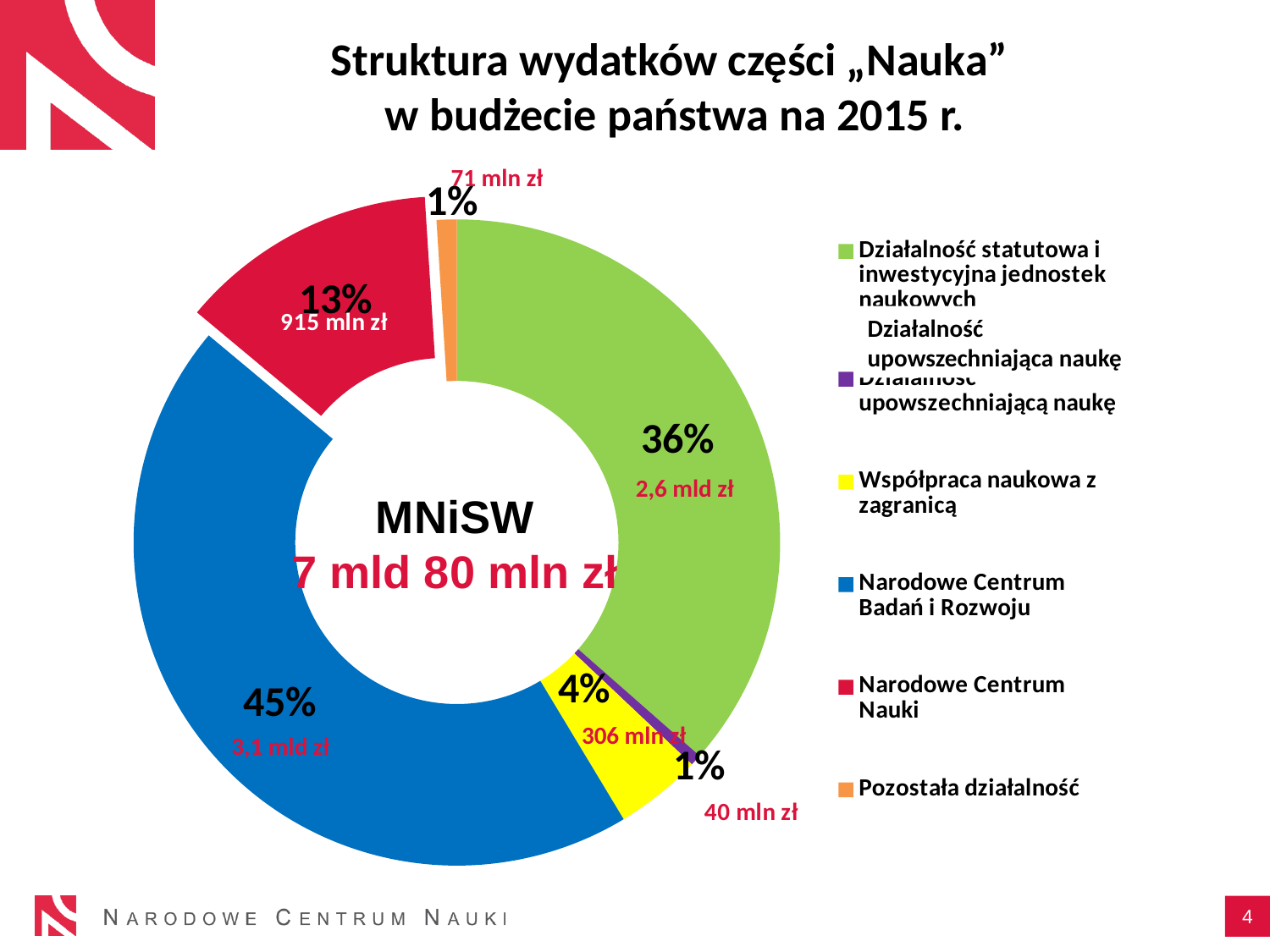
What share of the chart does Działalność statutowa i inwestycyjna jednostek naukowych account for? 36% Which has a larger share, Narodowe Centrum Nauki or Współpraca naukowa z zagranicą? Narodowe Centrum Nauki What share of the chart does Narodowe Centrum Nauki account for? 13% What share of the chart does Narodowe Centrum Badań i Rozwoju account for? 45% What amount is shown for Pozostała działalność? 71 mln zł What total amount is shown in the centre of the chart? 7 mld 80 mln zł What amount is shown for Współpraca naukowa z zagranicą? 306 mln zł Which category has the largest share of the chart? Narodowe Centrum Badań i Rozwoju What kind of chart is shown on the slide? Doughnut (pie) chart What is the difference in percentage points between the shares of Narodowe Centrum Badań i Rozwoju and Narodowe Centrum Nauki? 32 percentage points What amount is shown for Narodowe Centrum Nauki? 915 mln zł